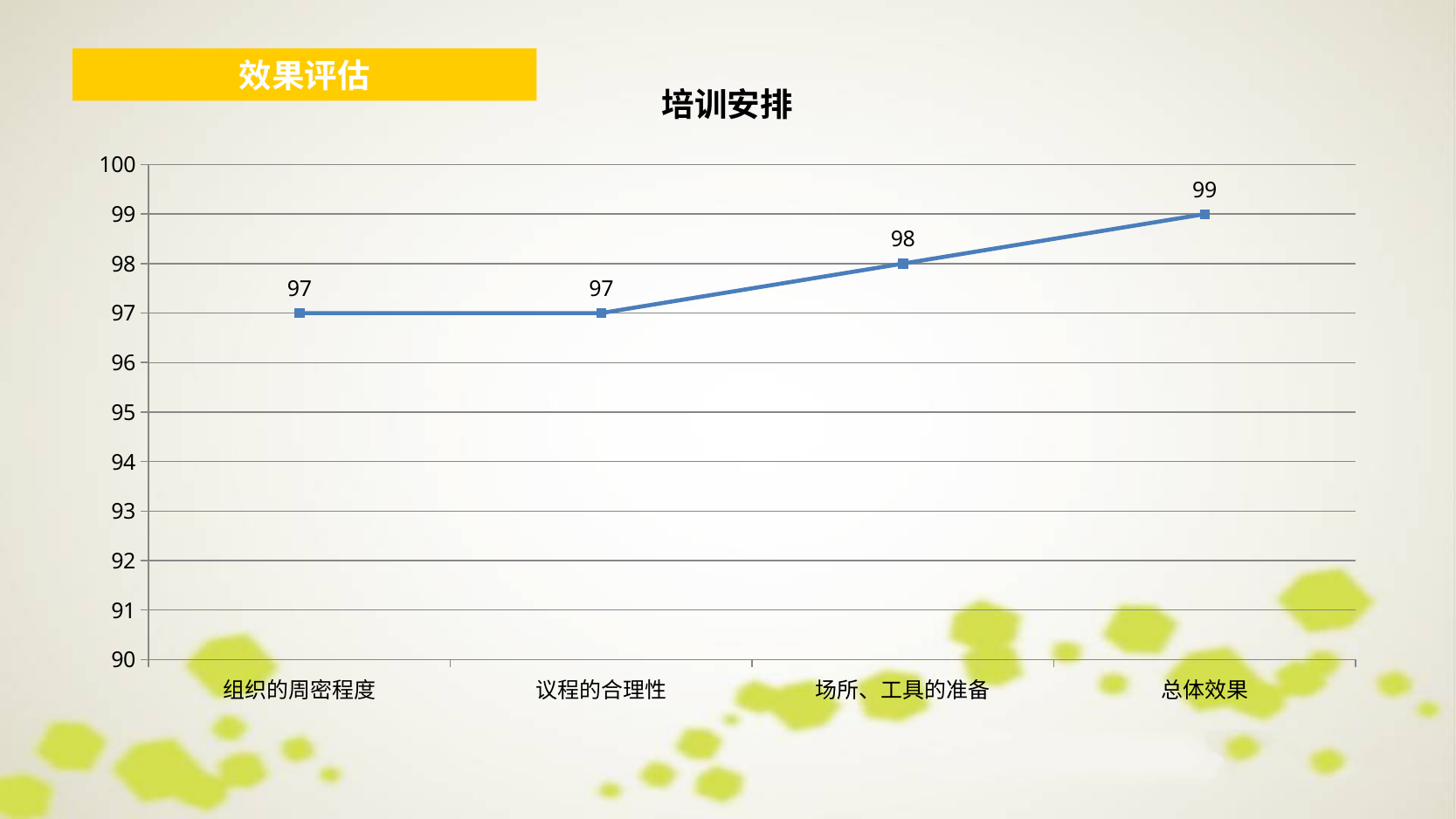
What is the value for 总体效果? 99 How many categories are shown on the x axis? 4 What is the title of the chart? 培训安排 Do the values rise or fall from left to right along the x axis? rise What is the value for 场所、工具的准备? 98 What is the value for 议程的合理性? 97 Which category has the highest value? 总体效果 Which is larger, the value for 场所、工具的准备 or the value for 议程的合理性? 场所、工具的准备 What kind of chart is shown on the slide? line chart Is the value for 总体效果 greater or less than 95? greater What is the difference between the values for 总体效果 and 组织的周密程度? 2 What is the value for 组织的周密程度? 97